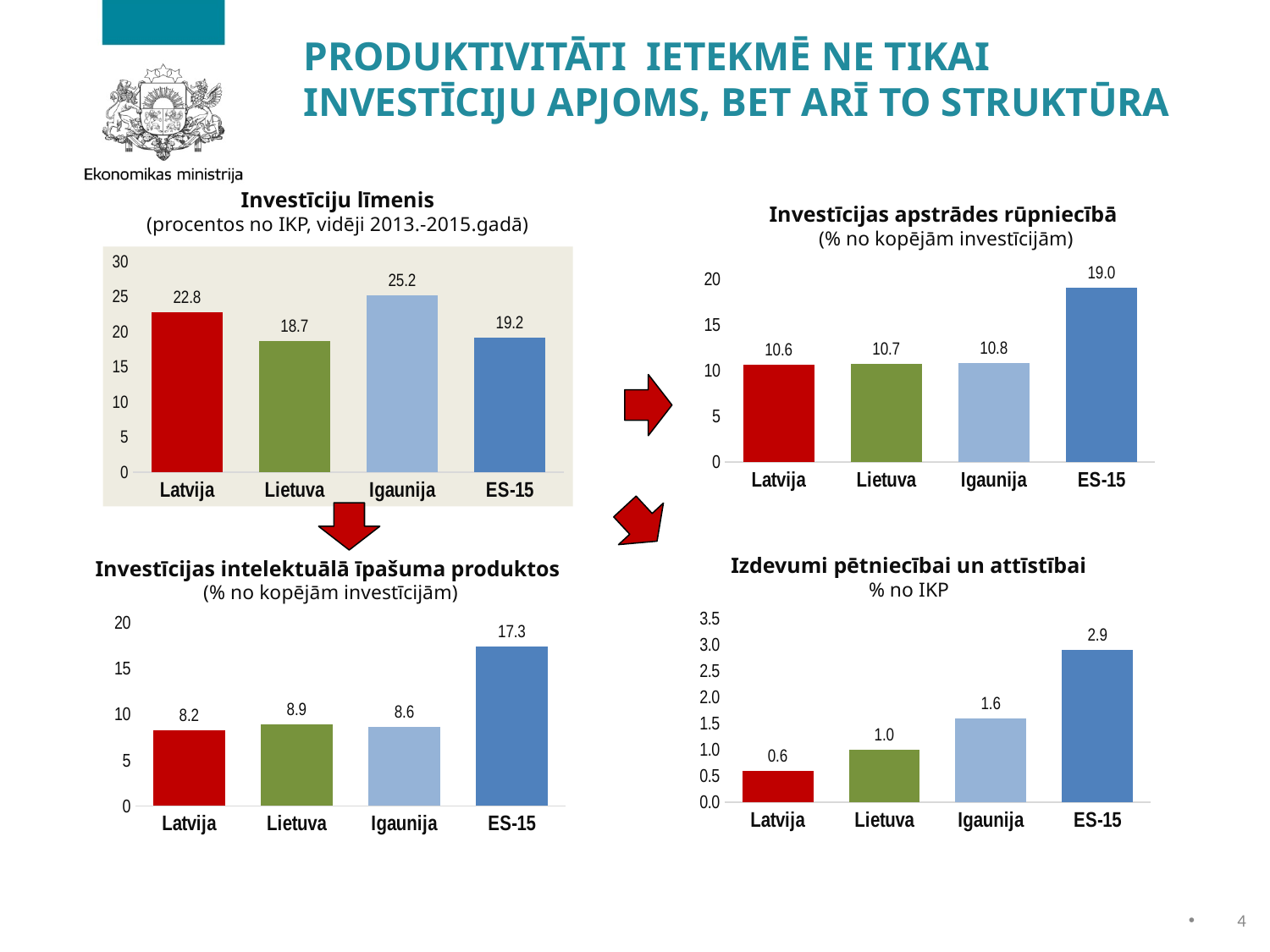
In the 'Investīciju līmenis' chart, what is the value for Igaunija? 25.2 What kind of chart is the 'Izdevumi pētniecībai un attīstībai' chart? bar chart In the 'Izdevumi pētniecībai un attīstībai' chart, do the values rise or fall from Latvija to ES-15? rise In the 'Izdevumi pētniecībai un attīstībai' chart, what is the value for Latvija? 0.6 In the 'Investīcijas apstrādes rūpniecībā' chart, which category has the highest value? ES-15 In the 'Investīcijas intelektuālā īpašuma produktos' chart, what is the difference between ES-15 and Latvija? 9.1 In the 'Investīcijas apstrādes rūpniecībā' chart, what is the value for ES-15? 19.0 In the 'Investīcijas intelektuālā īpašuma produktos' chart, what is the value for Lietuva? 8.9 In the 'Investīciju līmenis' chart, which category has the lowest value? Lietuva In the 'Izdevumi pētniecībai un attīstībai' chart, which is larger, Igaunija or Lietuva? Igaunija In the 'Investīciju līmenis' chart, what is the difference between Igaunija and Latvija? 2.4 In the 'Investīcijas apstrādes rūpniecībā' chart, how many categories are shown? 4